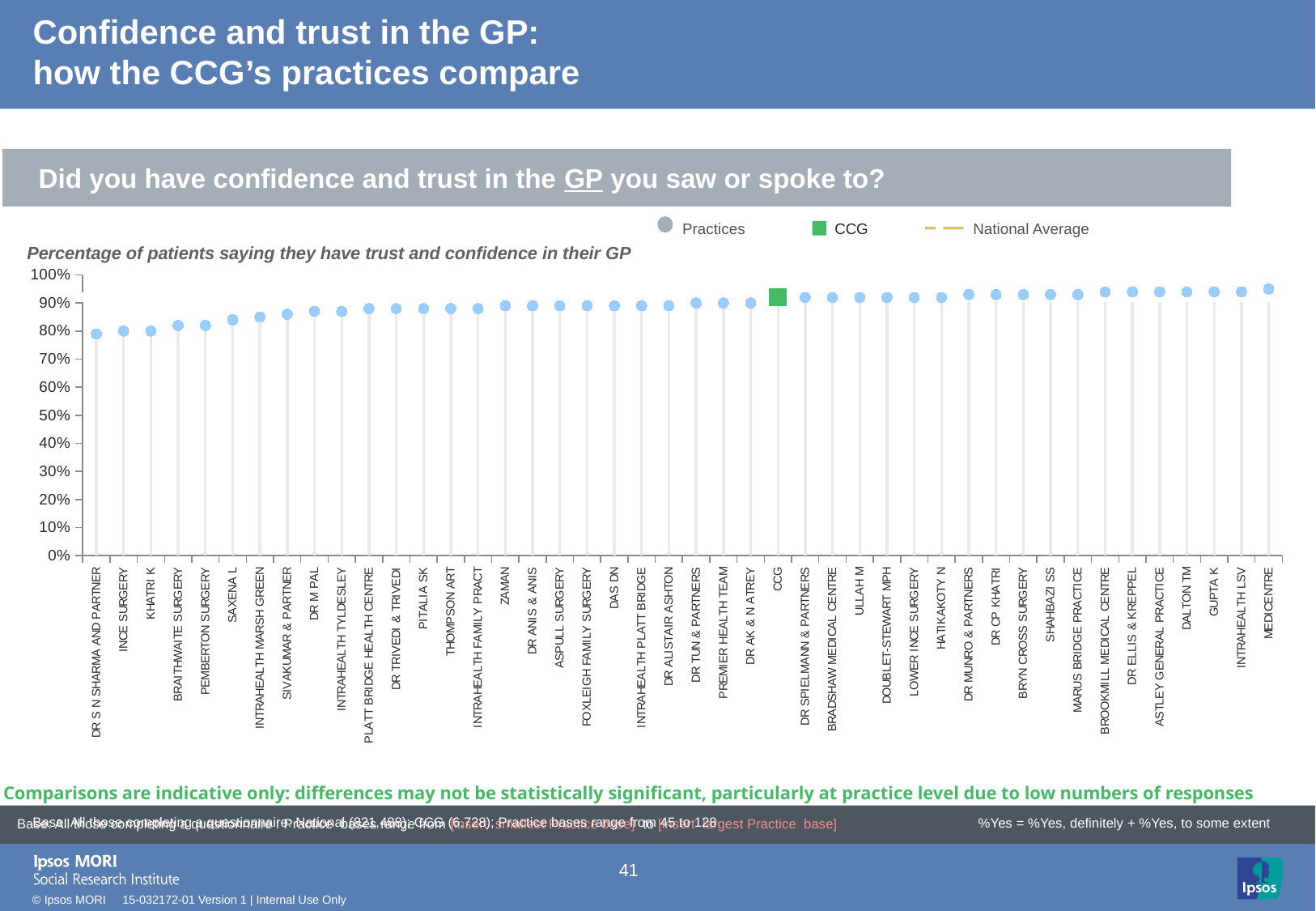
Which has the higher value, MEDICENTRE or DR S N SHARMA AND PARTNER? MEDICENTRE Is the value for MEDICENTRE greater or less than 90%? greater Is the value for PEMBERTON SURGERY greater or less than 70%? greater Is the value for CCG greater or less than 90%? greater What kind of chart is shown on the slide? Dot plot (lollipop chart) Which has the higher value, SAXENA L or GUPTA K? GUPTA K How many entries does the chart legend list? 3 Do the plotted values rise or fall moving from left to right along the x axis? Rise What colour is the marker used for the CCG in the chart? Green What are the three entries in the chart legend? Practices, CCG, National Average